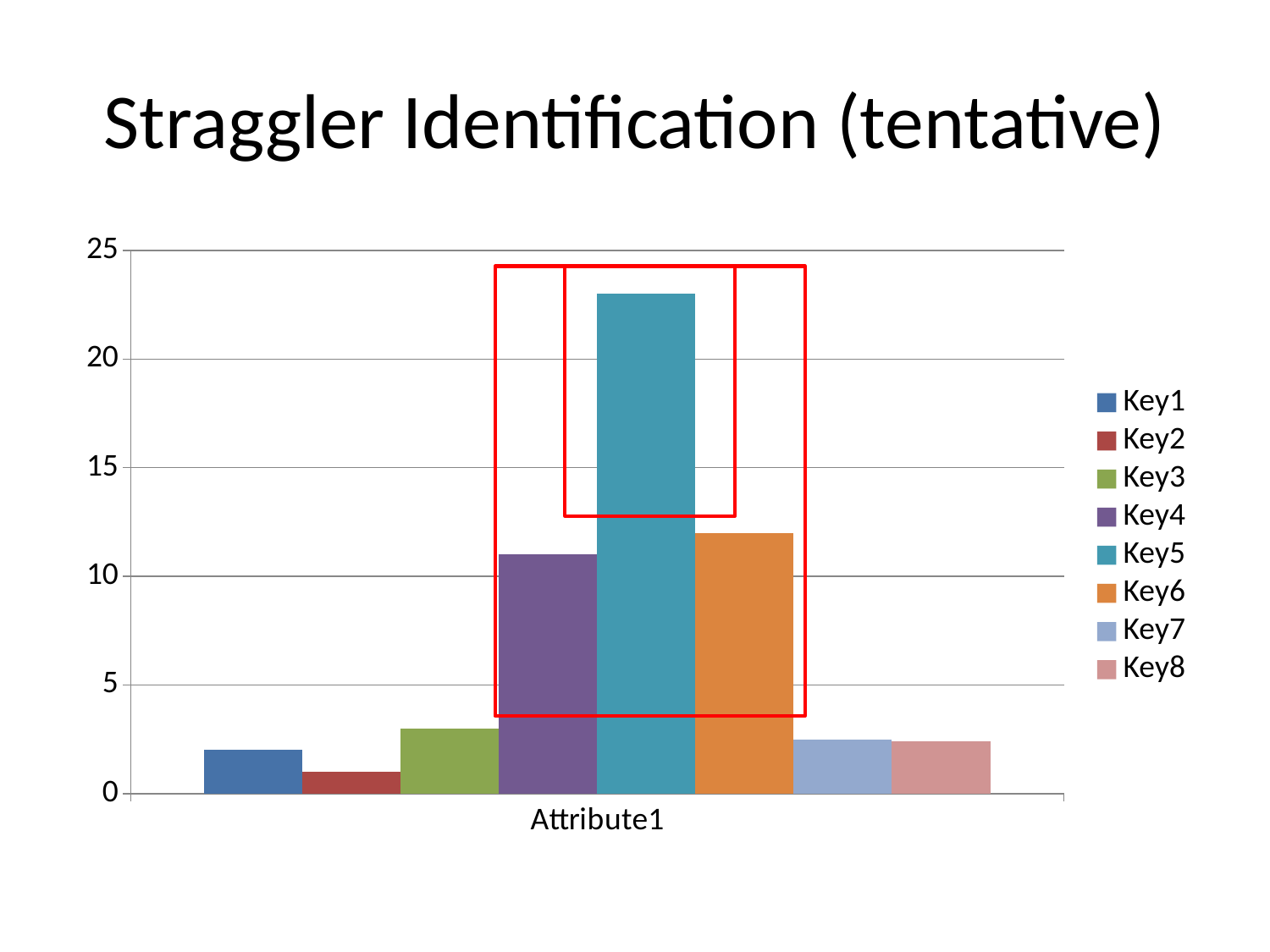
Is the value for Key4 greater or less than 10? greater Is the value for Key6 greater or less than 15? less How many categories are shown on the x axis? 1 Which is larger, the value for Key5 or the value for Key6? Key5 Is the value for Key5 greater or less than 20? greater Which series has the highest bar? Key5 What is the title of the slide containing the chart? Straggler Identification (tentative) What kind of chart is shown on the slide? bar chart Which is larger, the value for Key3 or the value for Key2? Key3 Which series has the lowest bar? Key2 How many series does the legend list? 8